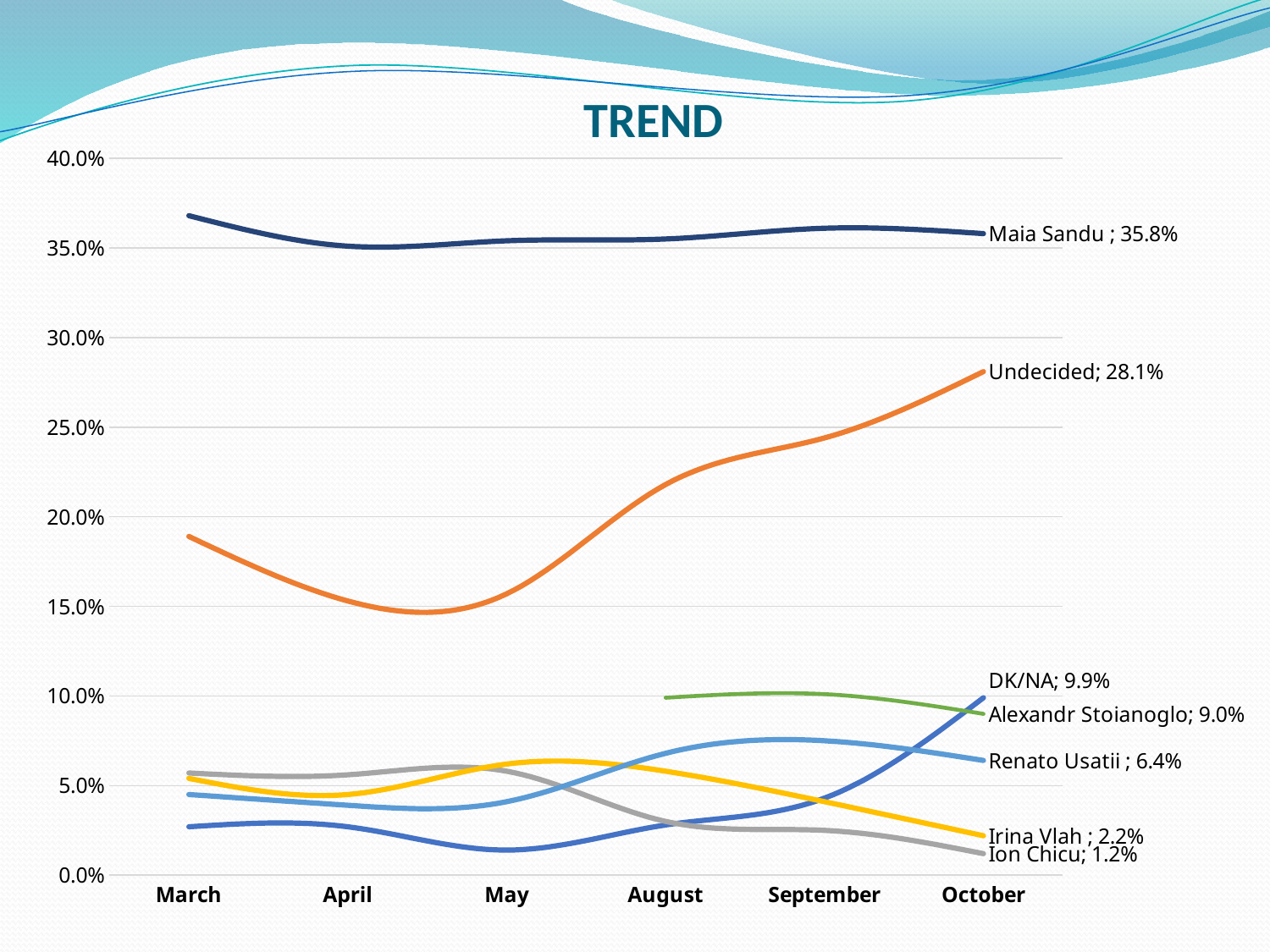
Which has the larger labelled October value, Irina Vlah or Ion Chicu? Irina Vlah Which series has the highest labelled value in October? Maia Sandu Which series has the lowest labelled value in October? Ion Chicu What is the difference between the labelled October values for Maia Sandu and Undecided? 7.7 percentage points What kind of chart is shown on the slide? line chart How many months are shown on the x axis? 6 What value is labelled for Maia Sandu at the end of the line (October)? 35.8% What is the title of the chart? TREND What value is labelled for Renato Usatii at the end of the line (October)? 6.4% What value is labelled for Undecided at the end of the line (October)? 28.1% What value is labelled for Ion Chicu at the end of the line (October)? 1.2% Is the value for Undecided in March greater or less than 15.0%? greater